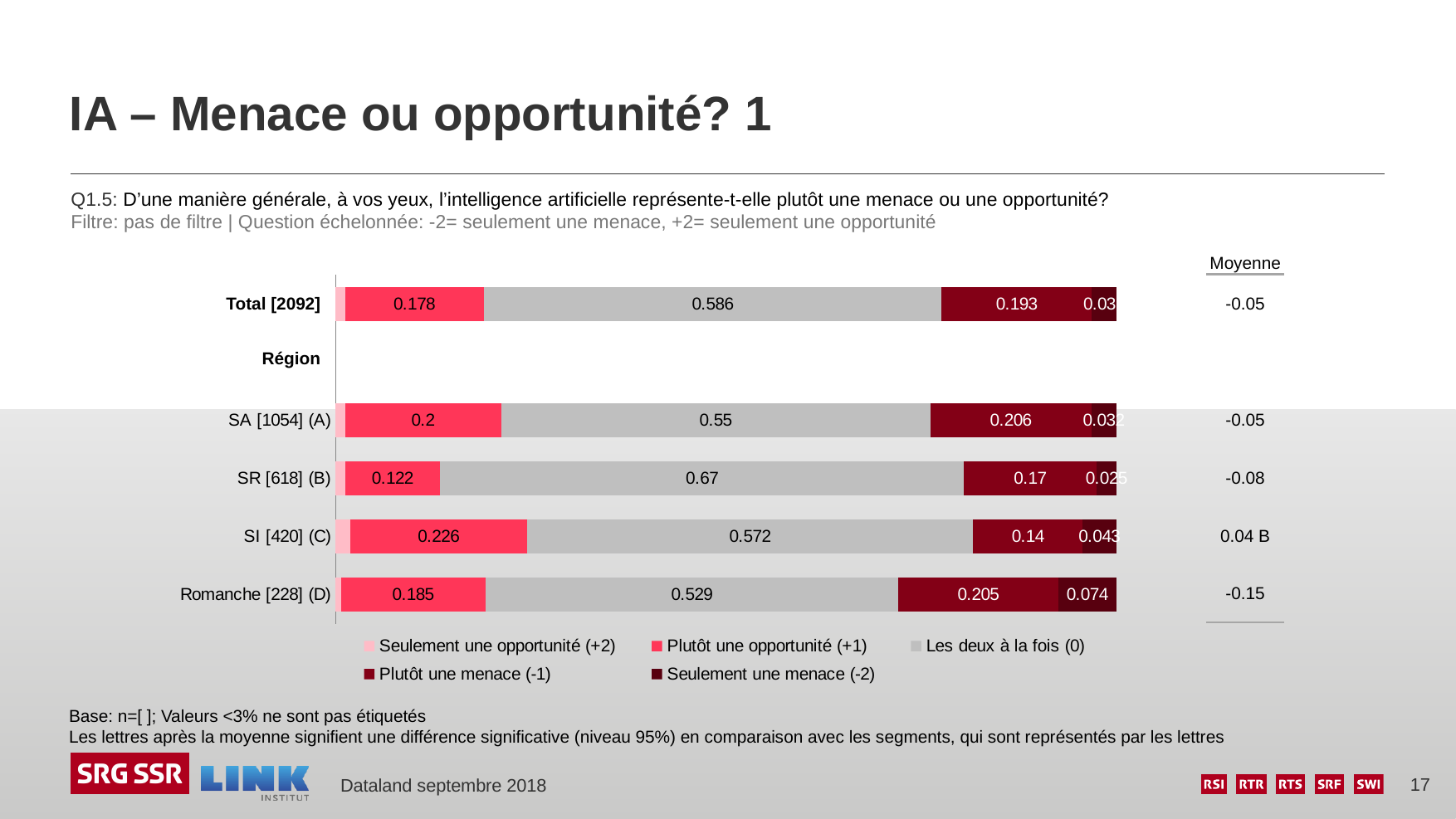
What is the value of "Plutôt une menace (-1)" for Total [2092]? 0.193 Which category has the lowest value for "Plutôt une opportunité (+1)"? SR [618] (B) Which has the larger "Plutôt une menace (-1)" value, SA [1054] (A) or SI [420] (C)? SA [1054] (A) How many series does the legend list? 5 What is the difference between the "Plutôt une opportunité (+1)" values for SA [1054] (A) and SR [618] (B)? 0.078 What is the value of "Plutôt une opportunité (+1)" for SI [420] (C)? 0.226 What is the value of "Les deux à la fois (0)" for SR [618] (B)? 0.67 Which category has the highest value for "Les deux à la fois (0)"? SR [618] (B) What is the value of "Seulement une menace (-2)" for Romanche [228] (D)? 0.074 What kind of chart is shown on the slide? Stacked bar chart What is the Moyenne value shown for Romanche [228] (D)? -0.15 How many categories (bars) are plotted in the chart? 5